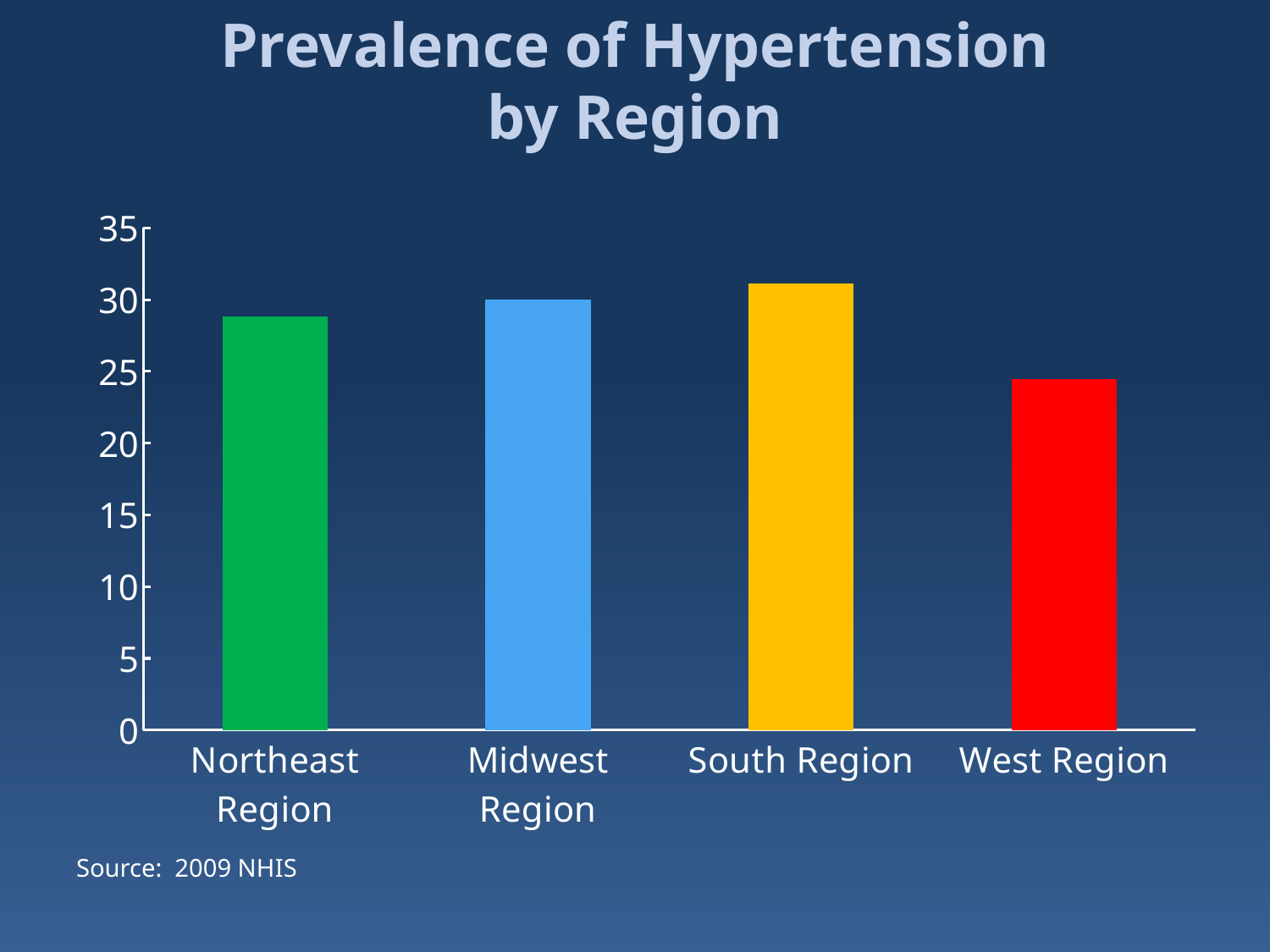
How many regions are shown on the chart? 4 Is the value for South Region greater or less than 30? greater Which is larger, the value for Northeast Region or the value for West Region? Northeast Region Which is larger, the value for South Region or the value for West Region? South Region What kind of chart is shown on the slide? bar chart What source is cited for the chart data? 2009 NHIS Is the value for Northeast Region greater or less than 25? greater Is the value for West Region greater or less than 25? less Which region has the highest prevalence of hypertension? South Region Which region has the lowest prevalence of hypertension? West Region What is the title of the chart? Prevalence of Hypertension by Region